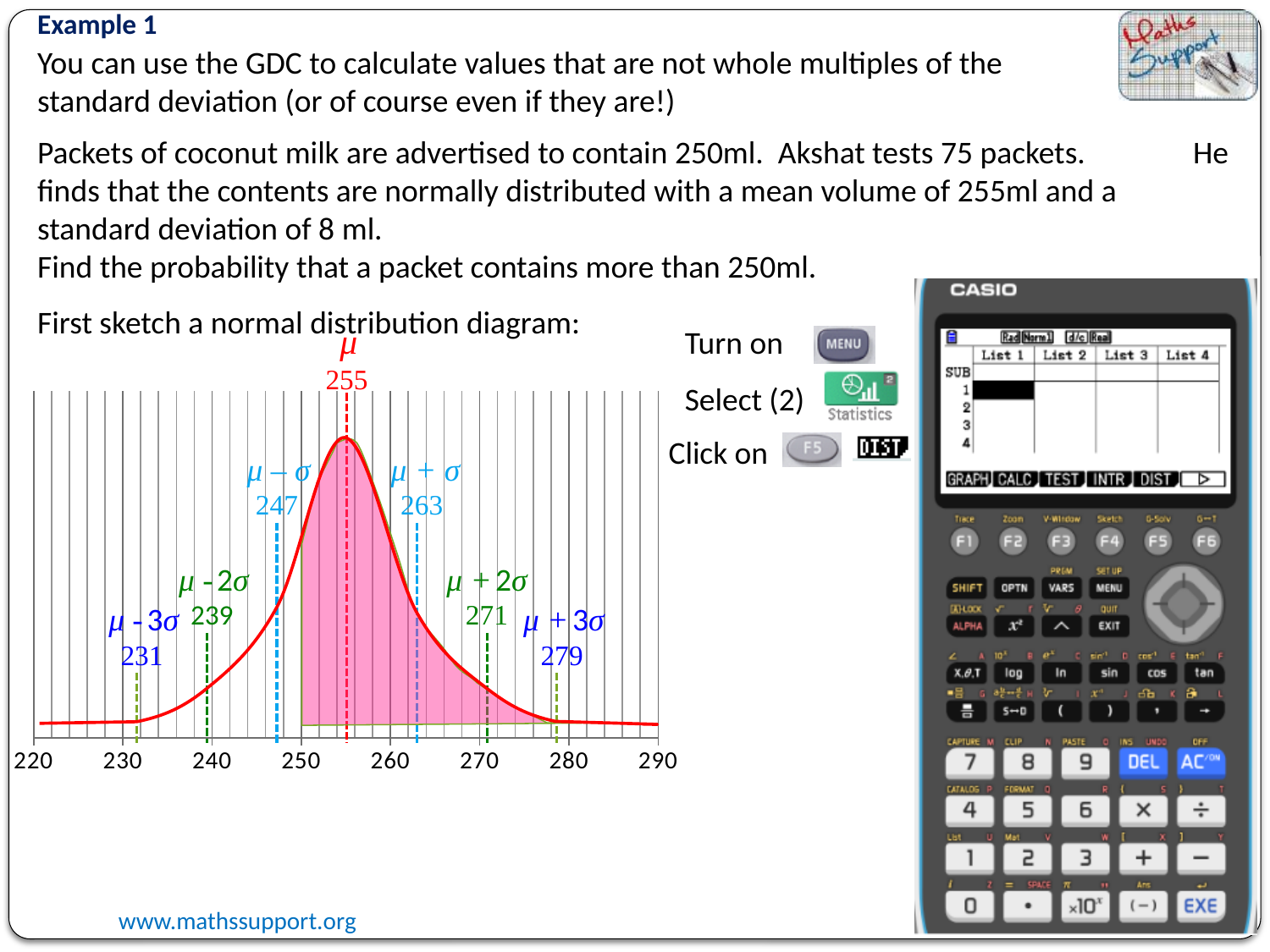
Which labelled value is larger, μ + 2σ or μ − 2σ? μ + 2σ Is the value labelled at μ + 3σ greater or less than 280? less What value is labelled at μ + 2σ on the diagram? 271 From which value on the horizontal axis does the pink shaded region under the curve begin? 250 How many numbered tick labels are shown on the horizontal axis of the diagram? 8 What value is labelled at μ − 3σ on the diagram? 231 What kind of diagram is sketched on the slide? A normal distribution curve What value is labelled at the mean μ on the normal distribution diagram? 255 What value is labelled at μ − σ on the diagram? 247 What is the difference between the values labelled at μ + σ and μ − σ? 16 What value is labelled at μ + σ on the diagram? 263 What is the difference between the values labelled at μ + 3σ and μ − 3σ? 48